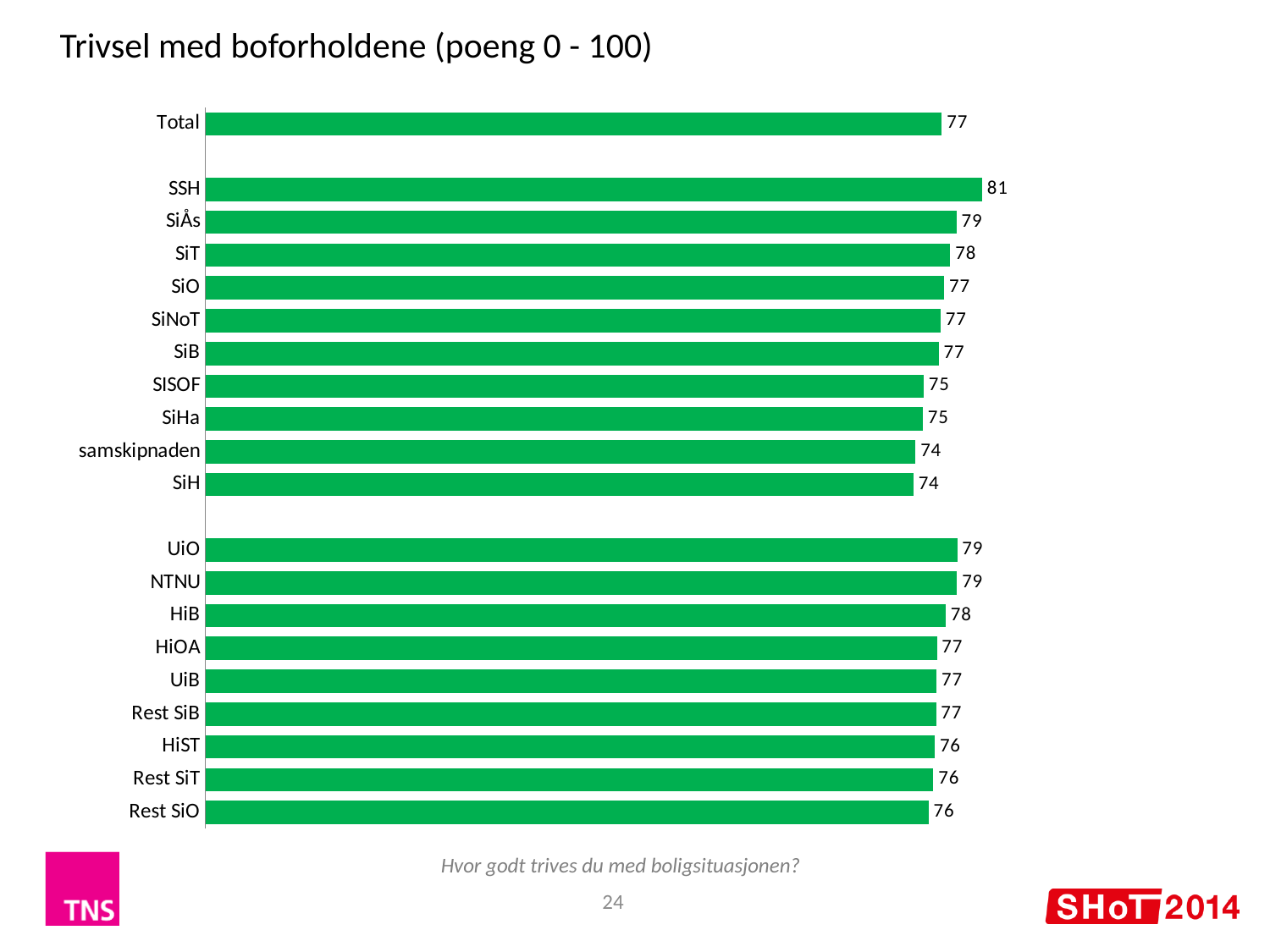
What is the lowest value shown on the chart? 74 What is the difference between the values for SSH and SiH? 7 What is the value for Rest SiO? 76 What is the value for samskipnaden? 74 Which has a larger value, SiÅs or HiST? SiÅs What is the value for Total? 77 What is the title of the chart? Trivsel med boforholdene (poeng 0 - 100) Which category has the highest value? SSH What colour are the bars in the chart? Green How many bars are shown on the chart? 20 What is the value for SSH? 81 What kind of chart is shown on the slide? Bar chart